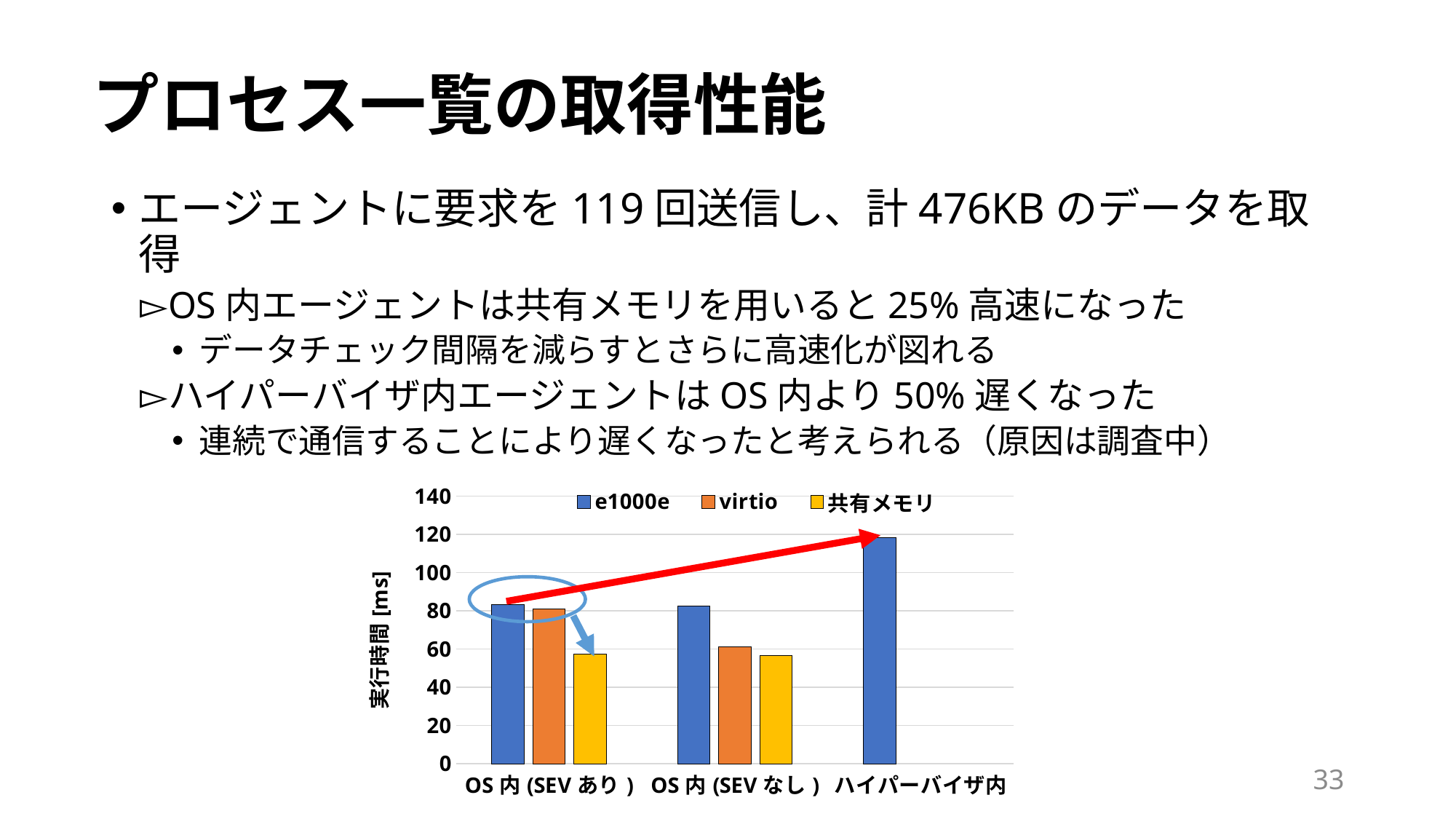
What is the label of the y axis of the chart? 実行時間 [ms] Which category has the highest e1000e bar? ハイパーバイザ内 Which series is shown in yellow in the chart? 共有メモリ Is the 共有メモリ value for OS 内 (SEV あり) greater or less than 80? less Is the virtio value for OS 内 (SEV なし) greater or less than 80? less How many series does the chart legend list? 3 Is the e1000e value for OS 内 (SEV なし) greater or less than 60? greater Which is larger: the virtio value for OS 内 (SEV あり) or the virtio value for OS 内 (SEV なし)? OS 内 (SEV あり) How many categories are shown on the x axis of the chart? 3 What kind of chart is shown on the slide? bar chart Within OS 内 (SEV なし), which series has the lowest bar? 共有メモリ